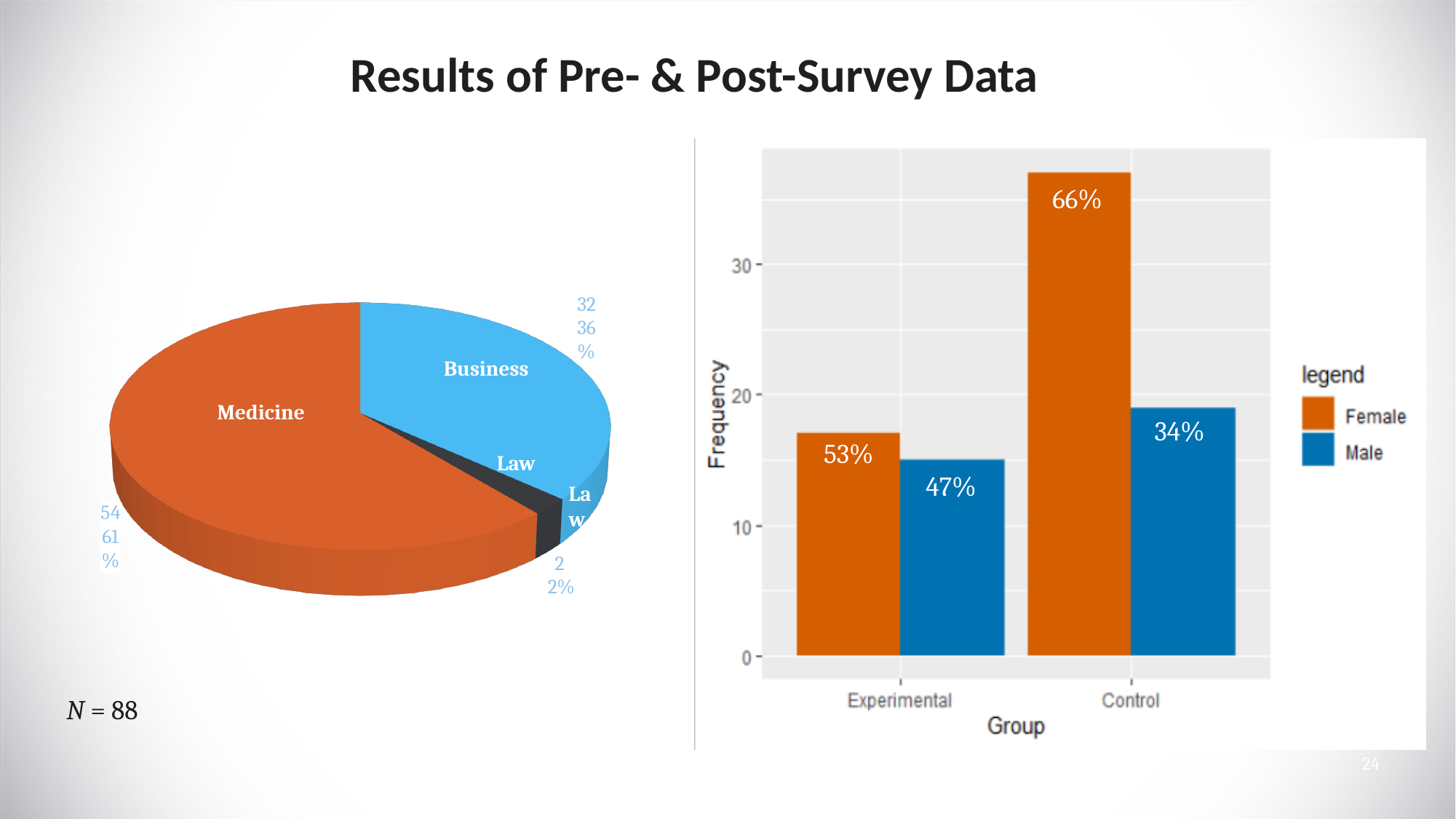
In the pie chart on the left, which slice is the smallest? Law In the bar chart on the right, which is larger for the Control group, the Female bar or the Male bar? Female In the bar chart on the right, is the Male bar for the Experimental group greater or less than 20 on the Frequency axis? less In the pie chart on the left, which slice is the largest? Medicine In the pie chart on the left, what count is shown for Medicine? 54 In the pie chart on the left, how many slices are there? 3 In the bar chart on the right, what percentage label is shown on the Female bar for the Control group? 66% In the bar chart on the right, how many series does the legend list? 2 In the pie chart on the left, what is the difference between the Medicine count and the Business count? 22 In the pie chart on the left, what percentage share does Business have? 36% What type of chart is on the left side of the slide? pie chart What type of chart is on the right side of the slide? bar chart